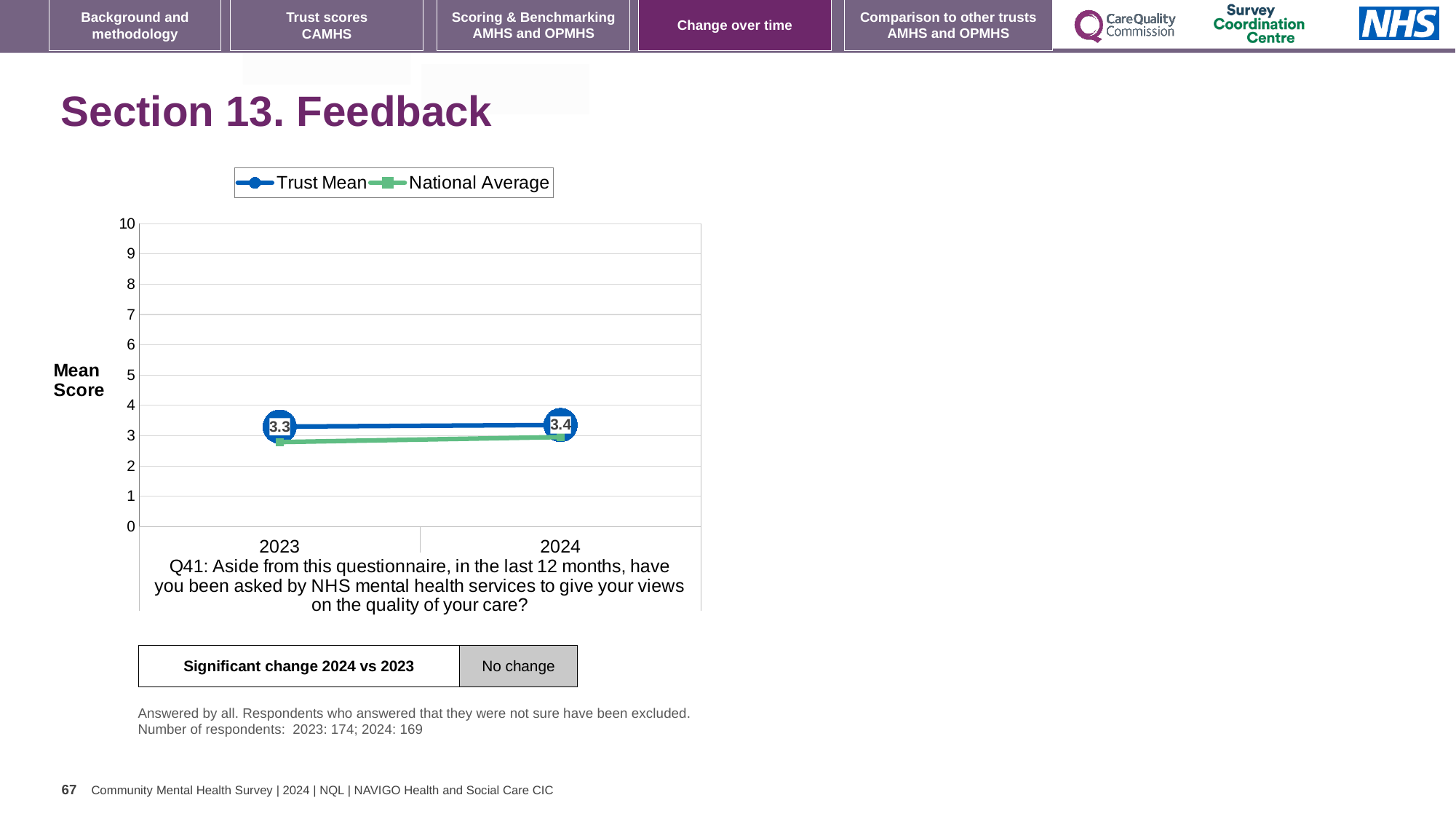
In which year is the Trust Mean higher? 2024 By how much did the Trust Mean change from 2023 to 2024? 0.1 In 2023, which is larger: the Trust Mean or the National Average? Trust Mean What is the Trust Mean value for 2023? 3.3 How many series does the legend list? 2 What is the Trust Mean value for 2024? 3.4 What are the two series named in the legend? Trust Mean and National Average Does the Trust Mean rise or fall from 2023 to 2024? rise What is the label on the y axis of the chart? Mean Score What kind of chart is shown on the slide? line chart Is the National Average value for 2023 greater or less than 3? less How many years are plotted on the x axis? 2